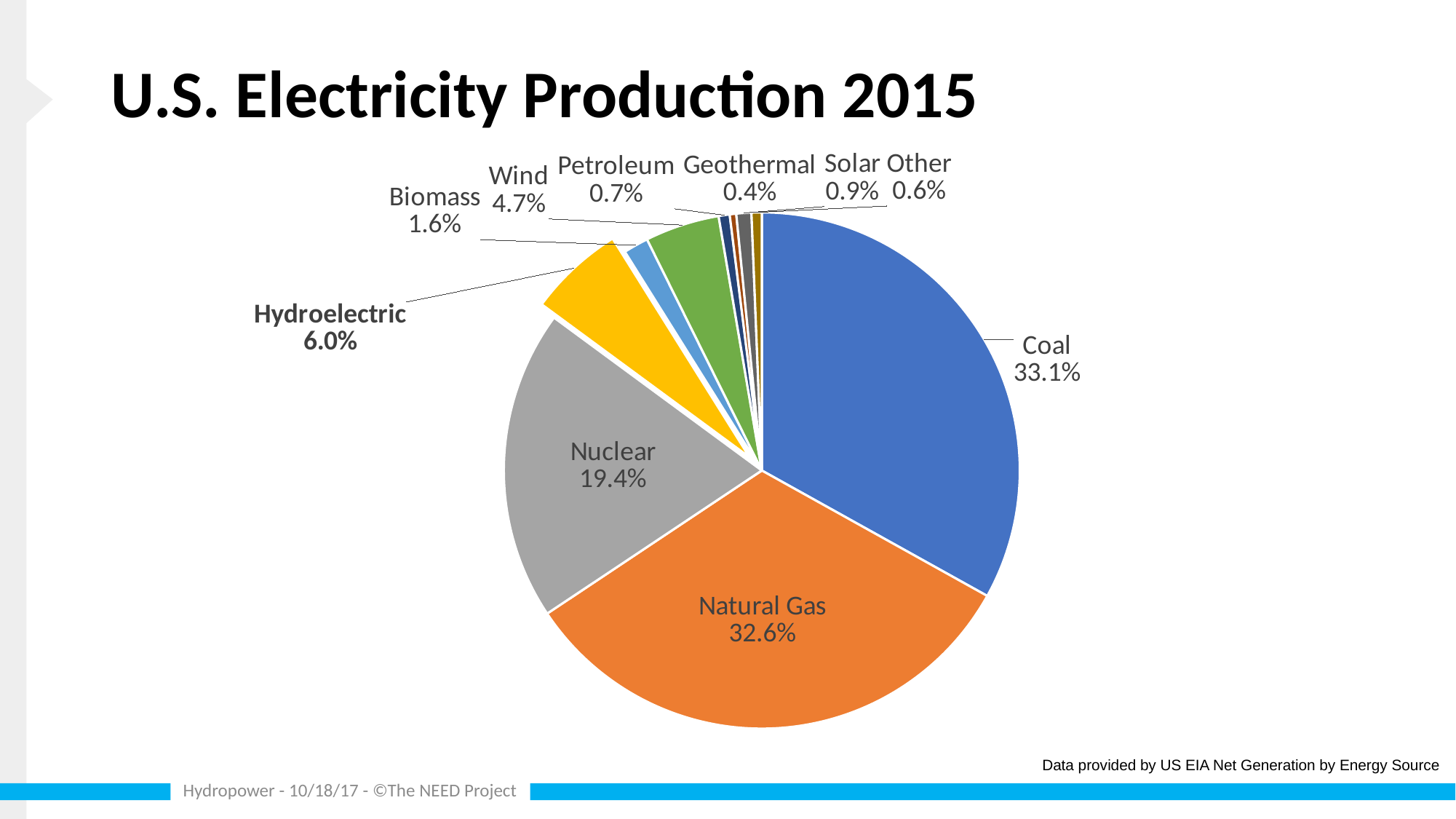
How many energy sources are shown in the pie chart? 10 What share of U.S. electricity production in 2015 came from Nuclear? 19.4% What share of U.S. electricity production in 2015 came from Coal? 33.1% Which energy source has the smallest share of U.S. electricity production in 2015? Geothermal What kind of chart is shown on the slide? Pie chart What is the title of the chart on the slide? U.S. Electricity Production 2015 What share of U.S. electricity production in 2015 came from Geothermal? 0.4% Which has a larger share, Solar or Petroleum? Solar What share of U.S. electricity production in 2015 came from Hydroelectric? 6.0% What is the difference in percentage points between the Coal and Natural Gas shares? 0.5 Which energy source has the largest share of U.S. electricity production in 2015? Coal Which has a larger share, Wind or Biomass? Wind